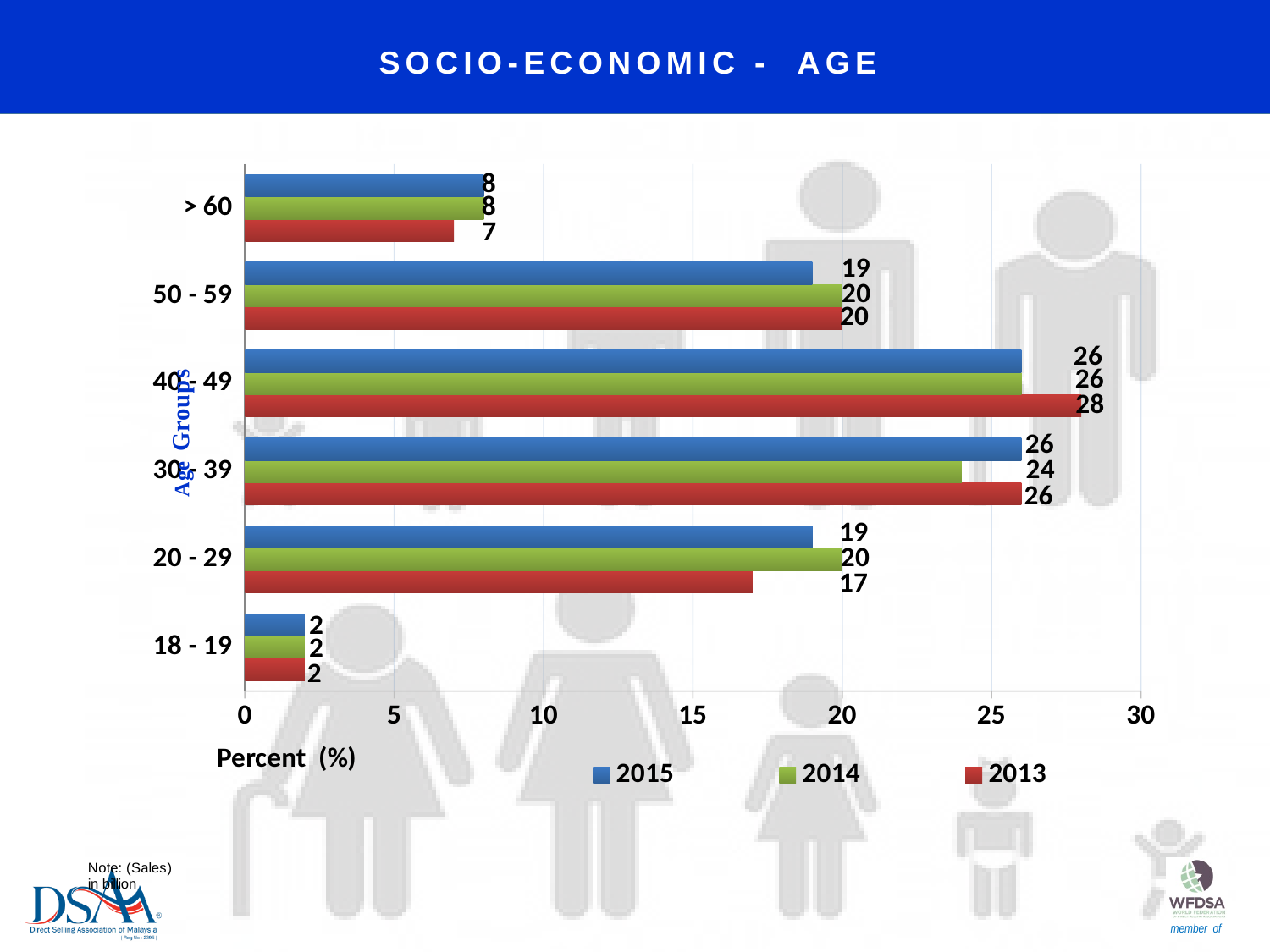
How many age groups are shown on the chart? 6 Which age group has the highest 2013 value? 40 - 49 How many series does the legend list? 3 What is the label of the horizontal axis? Percent (%) What is the 2013 value for the 20 - 29 age group? 17 What is the 2014 value for the 30 - 39 age group? 24 What is the 2013 value for the 40 - 49 age group? 28 What is the difference between the 2013 and 2015 values for the 40 - 49 age group? 2 What kind of chart is shown on the slide? Bar chart For the 20 - 29 age group, which is larger, the 2014 value or the 2013 value? 2014 What is the 2015 value for the 50 - 59 age group? 19 Which age group has the lowest 2015 value? 18 - 19